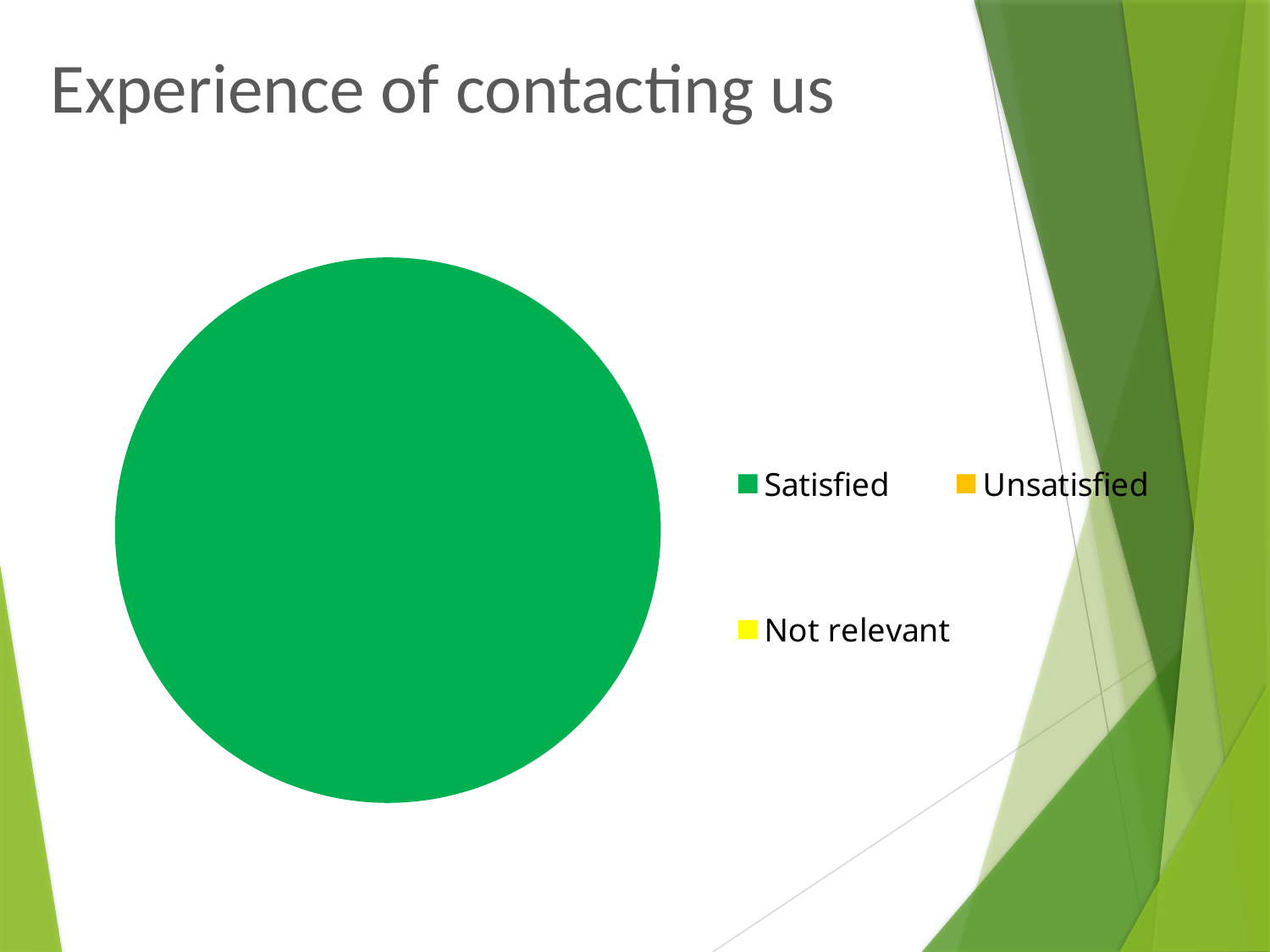
What kind of chart is shown on the slide? Pie chart Which category is shown in green in the pie chart legend? Satisfied What is the title of the chart on the slide? Experience of contacting us How many categories does the legend of the pie chart list? 3 Which is larger in the pie chart, the slice for Satisfied or the slice for Unsatisfied? Satisfied Which category has the largest slice of the pie chart? Satisfied Which is larger in the pie chart, the slice for Satisfied or the slice for Not relevant? Satisfied